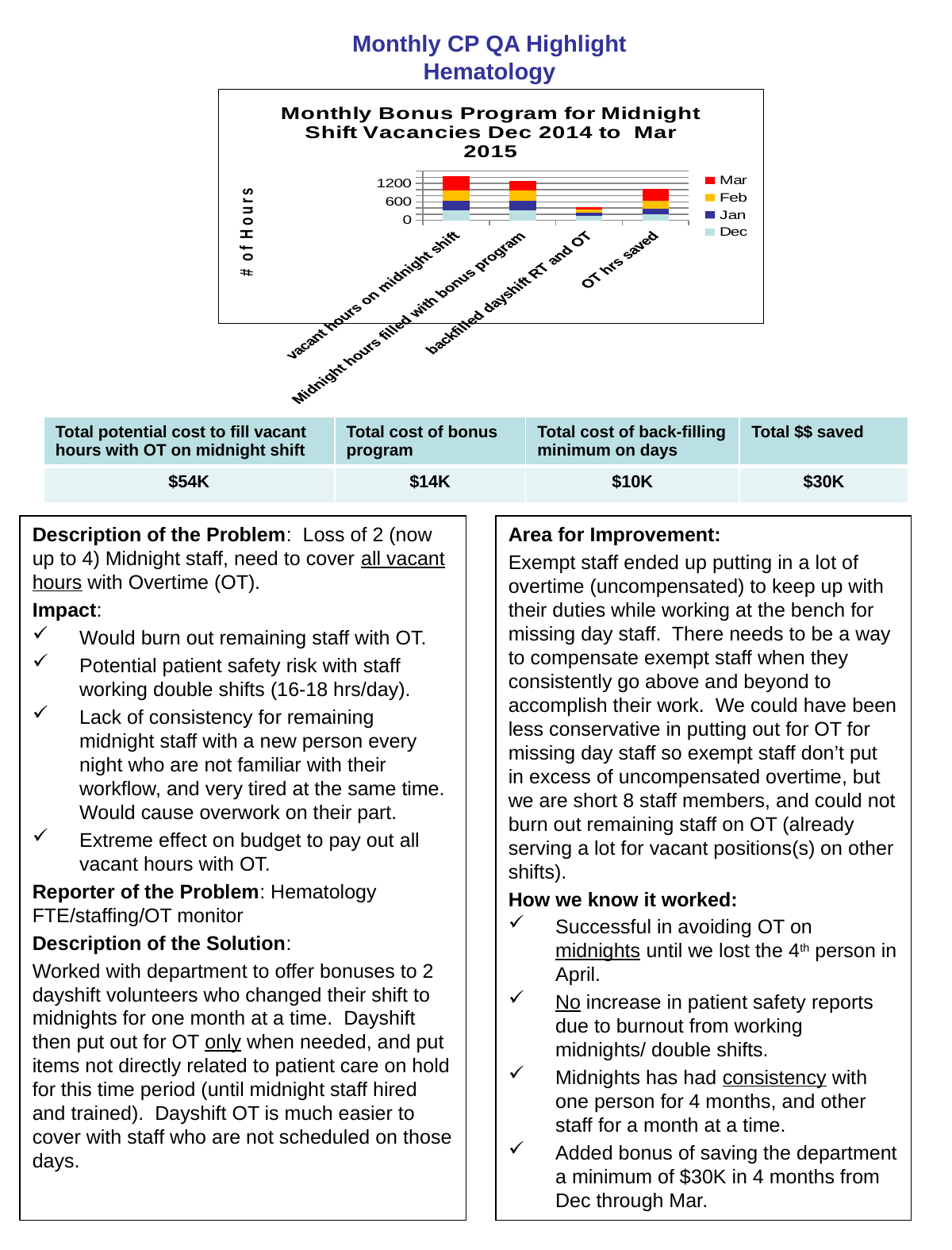
What is the label on the chart's vertical axis? # of Hours Is the total stacked value for 'vacant hours on midnight shift' greater or less than 600? greater What kind of chart is shown on the slide? Stacked bar chart What is the title of the chart? Monthly Bonus Program for Midnight Shift Vacancies Dec 2014 to Mar 2015 Which category has the lowest total stacked bar in the chart? backfilled dayshift RT and OT Which has the larger total stacked bar: 'vacant hours on midnight shift' or 'backfilled dayshift RT and OT'? vacant hours on midnight shift How many categories are shown on the x axis of the chart? 4 Which category has the highest total stacked bar in the chart? vacant hours on midnight shift Is the total stacked value for 'OT hrs saved' greater or less than 600? greater Which has the larger total stacked bar: 'OT hrs saved' or 'backfilled dayshift RT and OT'? OT hrs saved How many series does the chart's legend list? 4 Is the total stacked value for 'backfilled dayshift RT and OT' greater or less than 600? less